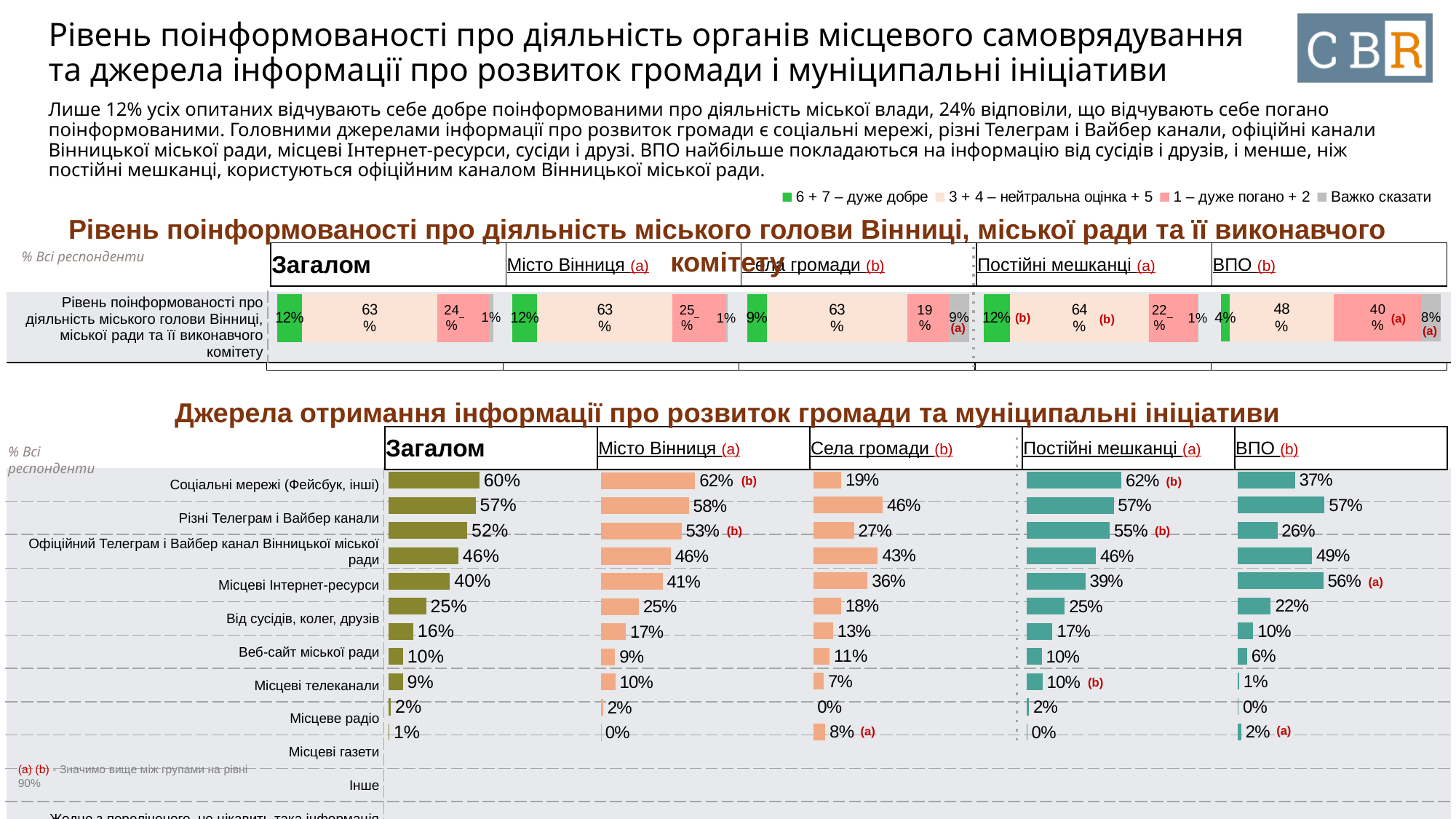
In the top chart 'Рівень поінформованості...', how many series does the legend list? 4 In the top chart 'Рівень поінформованості...', what is the '6 + 7 – дуже добре' value for Загалом? 12% In the top chart 'Рівень поінформованості...', how many respondent groups are shown? 5 In the top chart 'Рівень поінформованості про діяльність міського голови Вінниці, міської ради та її виконавчого комітету', what kind of chart is it? Stacked bar chart In the bottom chart 'Джерела отримання інформації...', what is the Загалом value for 'Соціальні мережі (Фейсбук, інші)'? 60% In the top chart 'Рівень поінформованості...', what is the '1 – дуже погано + 2' value for ВПО? 40% In the top chart 'Рівень поінформованості...', which group has the lowest '6 + 7 – дуже добре' share? ВПО In the top chart 'Рівень поінформованості...', what is the 'Важко сказати' value for Села громади? 9% In the bottom chart 'Джерела отримання інформації про розвиток громади та муніципальні ініціативи', what is the highest value in the Загалом column? 60% In the top chart 'Рівень поінформованості...', which has the larger '3 + 4 – нейтральна оцінка + 5' value: Постійні мешканці or ВПО? Постійні мешканці In the top chart 'Рівень поінформованості...', what is the difference between the '1 – дуже погано + 2' values for ВПО and Загалом? 16 percentage points In the top chart 'Рівень поінформованості...', which group has the highest '1 – дуже погано + 2' share? ВПО